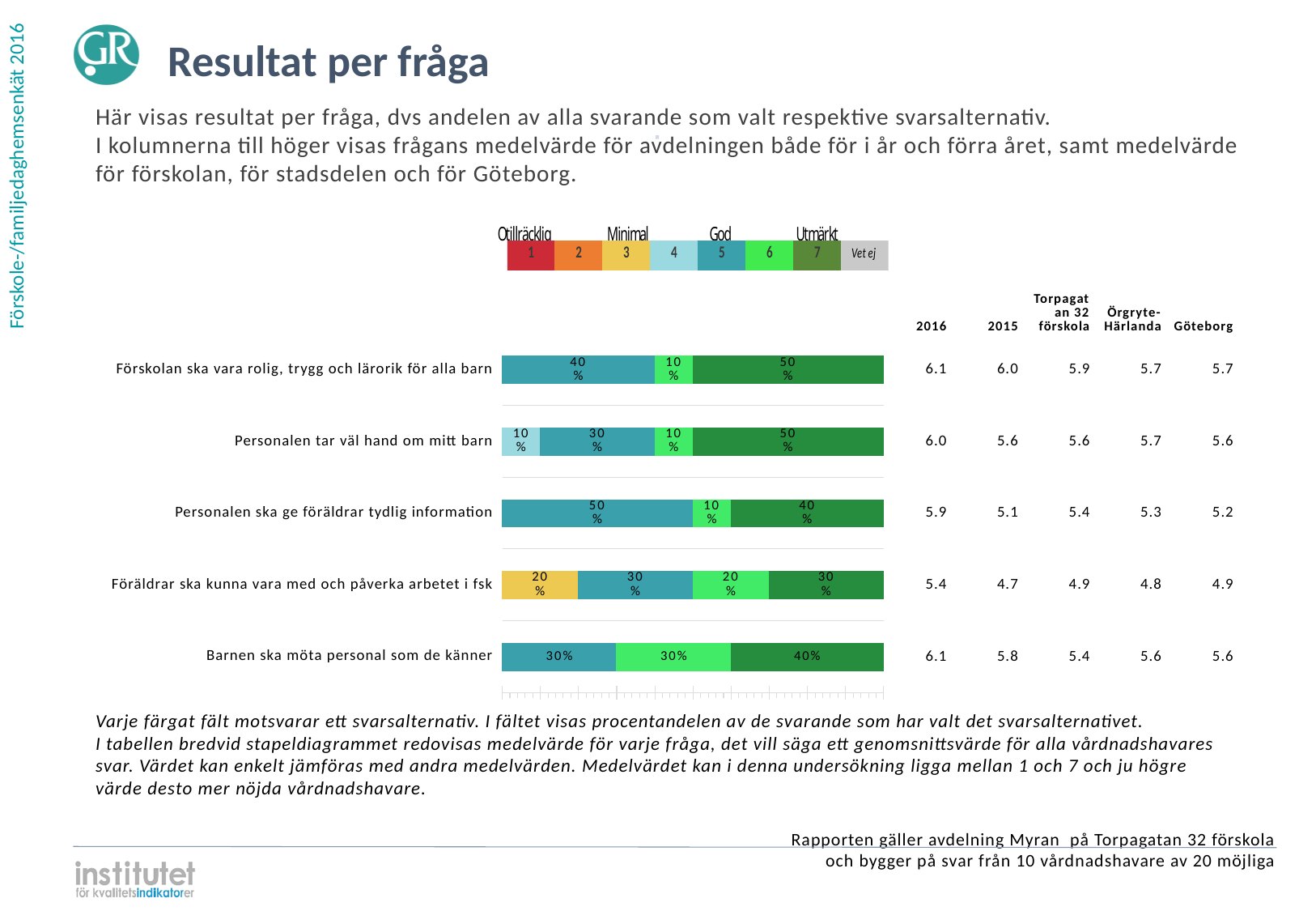
What percentage of respondents chose answer 4 (light blue) for 'Personalen tar väl hand om mitt barn'? 10% Which question has the smallest share of respondents choosing answer 7 (dark green)? Föräldrar ska kunna vara med och påverka arbetet i fsk What label does the legend give to the grey answer alternative at the far right? Vet ej What is the difference between the answer 7 share for 'Personalen tar väl hand om mitt barn' and for 'Personalen ska ge föräldrar tydlig information'? 10% What percentage of respondents chose answer 7 (dark green) for 'Förskolan ska vara rolig, trygg och lärorik för alla barn'? 50% Which is larger: the answer 5 share for 'Förskolan ska vara rolig, trygg och lärorik för alla barn' or for 'Barnen ska möta personal som de känner'? Förskolan ska vara rolig, trygg och lärorik för alla barn What percentage of respondents chose answer 3 (yellow) for 'Föräldrar ska kunna vara med och påverka arbetet i fsk'? 20% Which question has the largest share of respondents choosing answer 5 (teal)? Personalen ska ge föräldrar tydlig information How many answer alternatives does the legend above the chart list? 8 What percentage of respondents chose answer 6 (light green) for 'Barnen ska möta personal som de känner'? 30% How many questions (categories) are plotted in the bar chart? 5 What kind of chart is shown on the slide? stacked bar chart